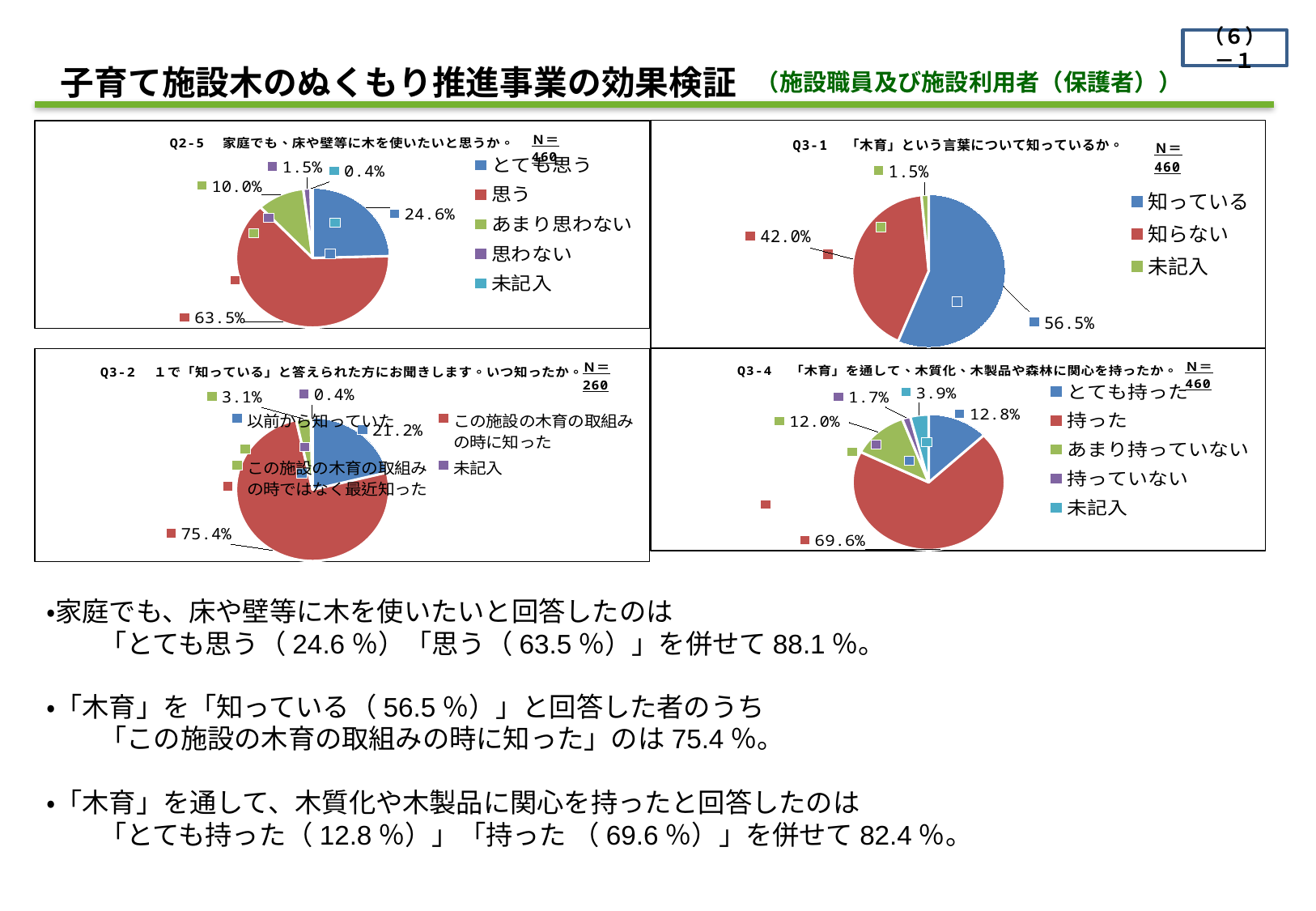
In the top-left pie chart (Q2-5), which response category has the largest share? 思う How many categories does the legend of the top-right pie chart (Q3-1) list? 3 In the top-right pie chart (Q3-1), what is the difference between the 「知っている」 and 「知らない」 shares? 14.5% In the bottom-right pie chart (Q3-4), what percentage of respondents answered 「持った」? 69.6% In the bottom-right pie chart (Q3-4), which is larger, the share for 「とても持った」 or the share for 「あまり持っていない」? とても持った In the top-right pie chart (Q3-1), what percentage of respondents answered 「知っている」? 56.5% In the bottom-left pie chart (Q3-2), what percentage of respondents answered 「以前から知っていた」? 21.2% In the top-left pie chart (Q2-5), which response category has the smallest share? 未記入 In the top-left pie chart (Q2-5), what percentage of respondents answered 「思う」? 63.5% What type of chart is used for Q3-4 in the bottom-right of the slide? Pie chart In the bottom-left pie chart (Q3-2), what percentage of respondents answered 「この施設の木育の取組みの時に知った」? 75.4% In the top-left pie chart (Q2-5), what percentage of respondents answered 「とても思う」? 24.6%